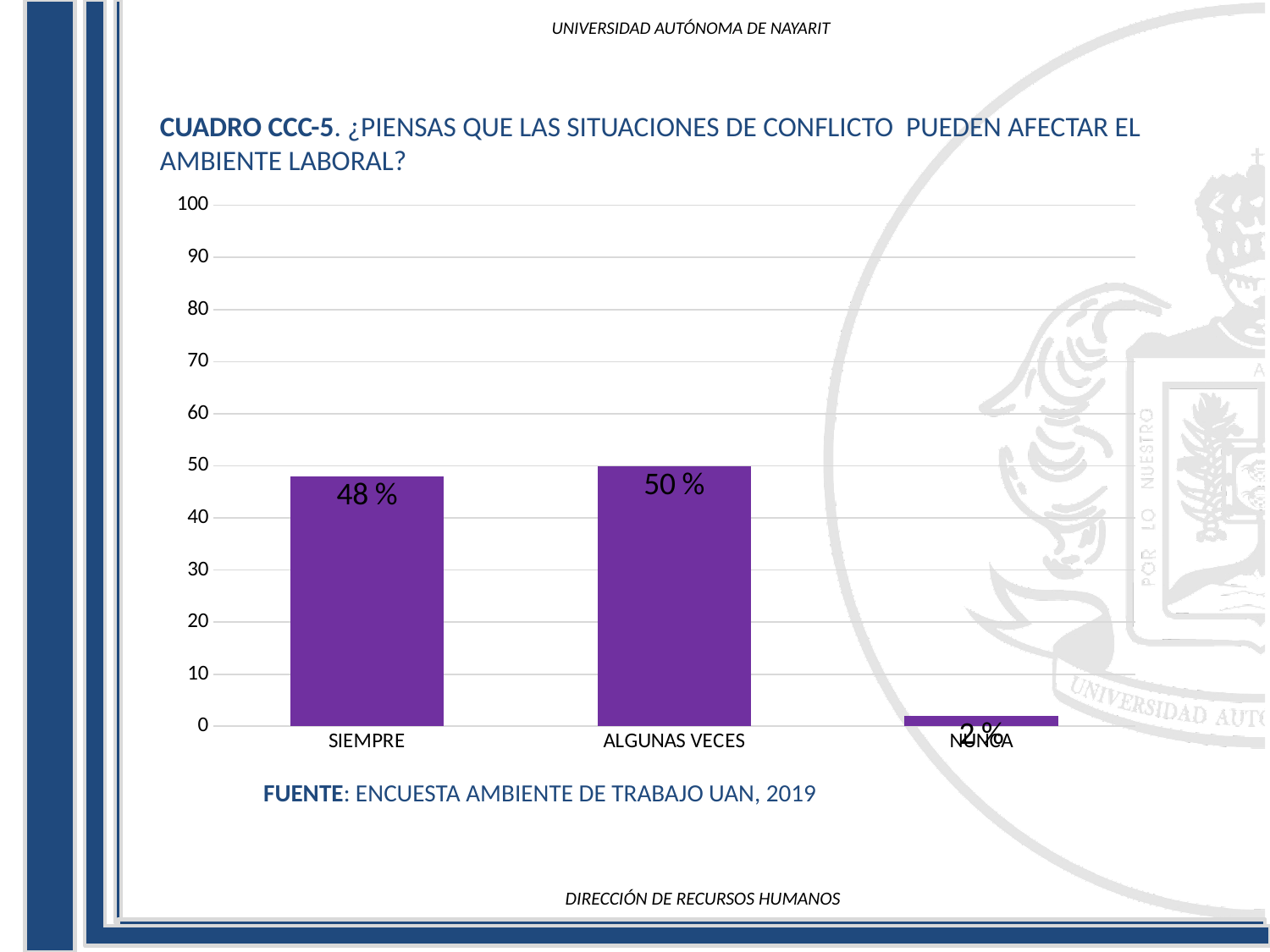
What kind of chart is shown on the slide? bar chart What source is cited below the chart? ENCUESTA AMBIENTE DE TRABAJO UAN, 2019 Which is larger, the value for SIEMPRE or the value for NUNCA? SIEMPRE Is the value for SIEMPRE greater or less than 40? greater What is the difference between the values for ALGUNAS VECES and SIEMPRE? 2 % What is the value for NUNCA? 2 % Which category has the highest value? ALGUNAS VECES What is the value for ALGUNAS VECES? 50 % Which category has the lowest value? NUNCA What is the difference between the values for SIEMPRE and NUNCA? 46 % How many categories are shown on the x axis? 3 What is the value for SIEMPRE? 48 %